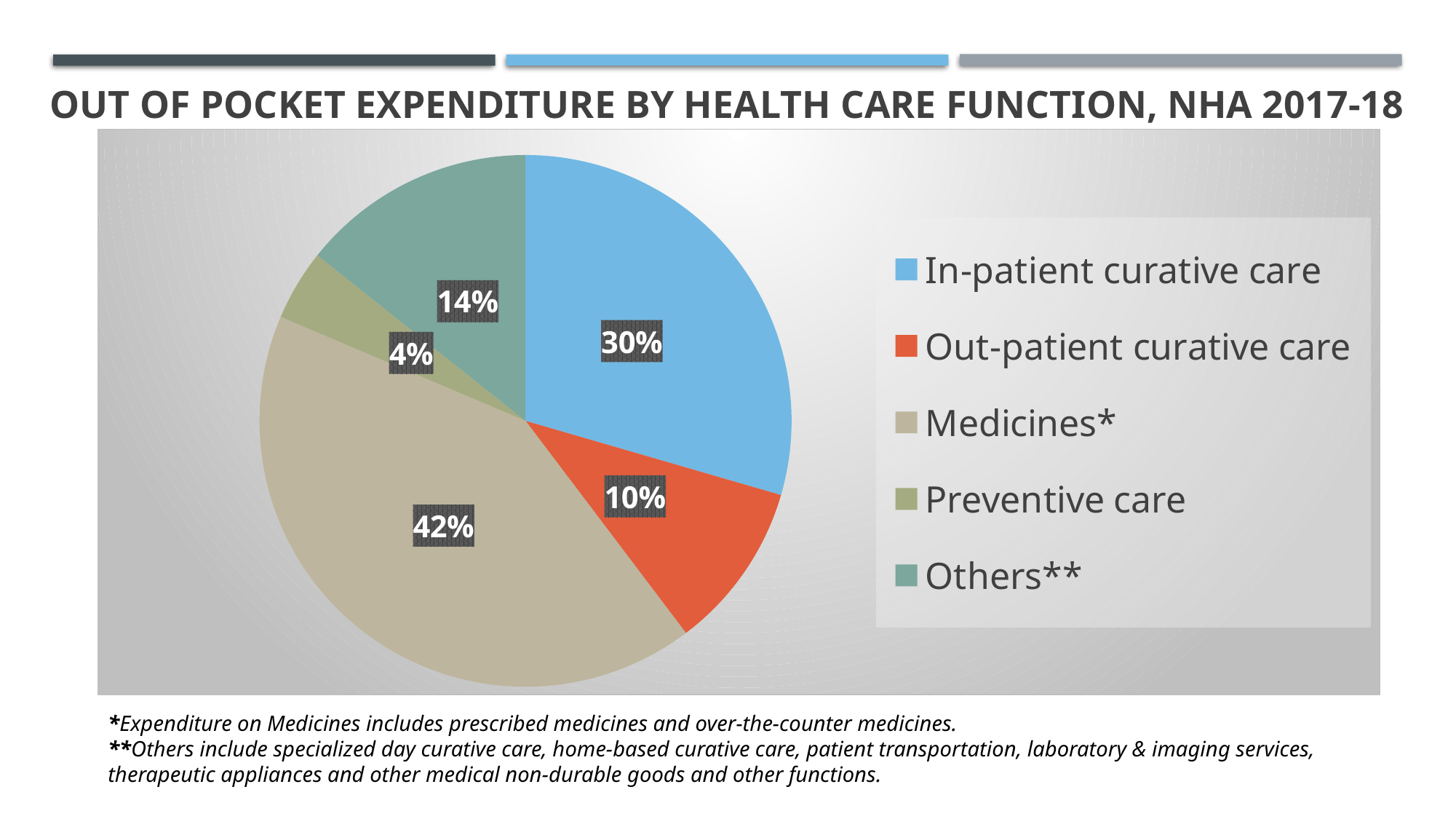
How many categories does the pie chart show? 5 What is the difference in percentage points between the Medicines* share and the In-patient curative care share? 12 What colour represents Out-patient curative care in the pie chart? Red What share of out of pocket expenditure goes to In-patient curative care? 30% What share of out of pocket expenditure goes to Preventive care? 4% Which is larger, the share for Others** or the share for Out-patient curative care? Others** Which health care function has the smallest share of out of pocket expenditure? Preventive care What kind of chart is shown on the slide? Pie chart What share of out of pocket expenditure goes to Out-patient curative care? 10% Which health care function has the largest share of out of pocket expenditure? Medicines* What share of out of pocket expenditure goes to Others**? 14% What share of out of pocket expenditure goes to Medicines*? 42%